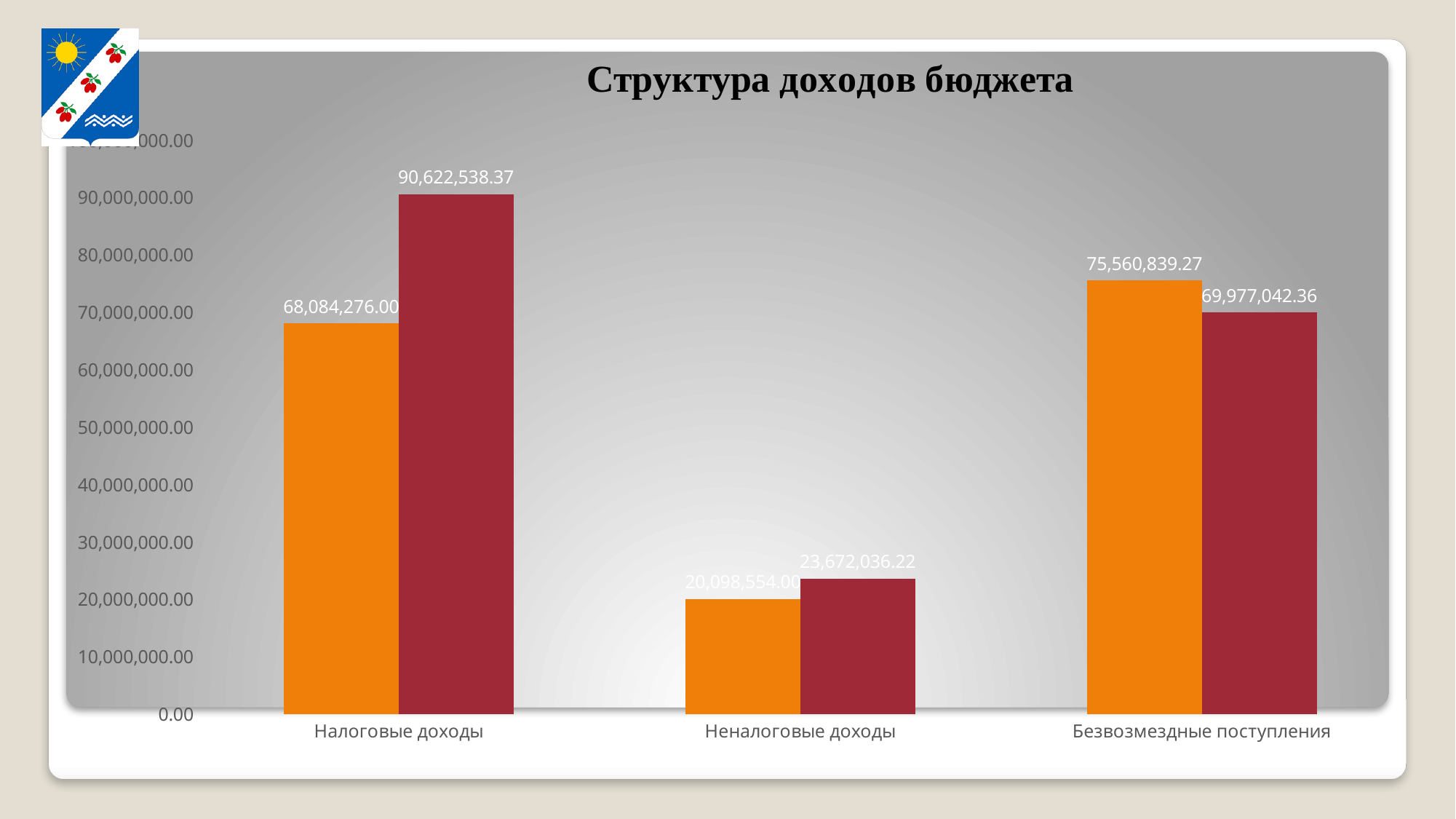
Which category has the lowest orange bar? Неналоговые доходы What is the value of the orange bar for Налоговые доходы? 68,084,276.00 How many categories are shown on the x axis of the chart? 3 What is the difference between the dark red and orange bars for Налоговые доходы? 22,538,262.37 What is the title of the chart? Структура доходов бюджета What is the value of the orange bar for Безвозмездные поступления? 75,560,839.27 Which category has the highest dark red bar? Налоговые доходы For Безвозмездные поступления, which bar is larger, the orange or the dark red one? orange What is the value of the dark red bar for Налоговые доходы? 90,622,538.37 Is the orange bar for Неналоговые доходы greater or less than 30,000,000.00? less What type of chart is shown on the slide? bar chart What is the value of the dark red bar for Неналоговые доходы? 23,672,036.22